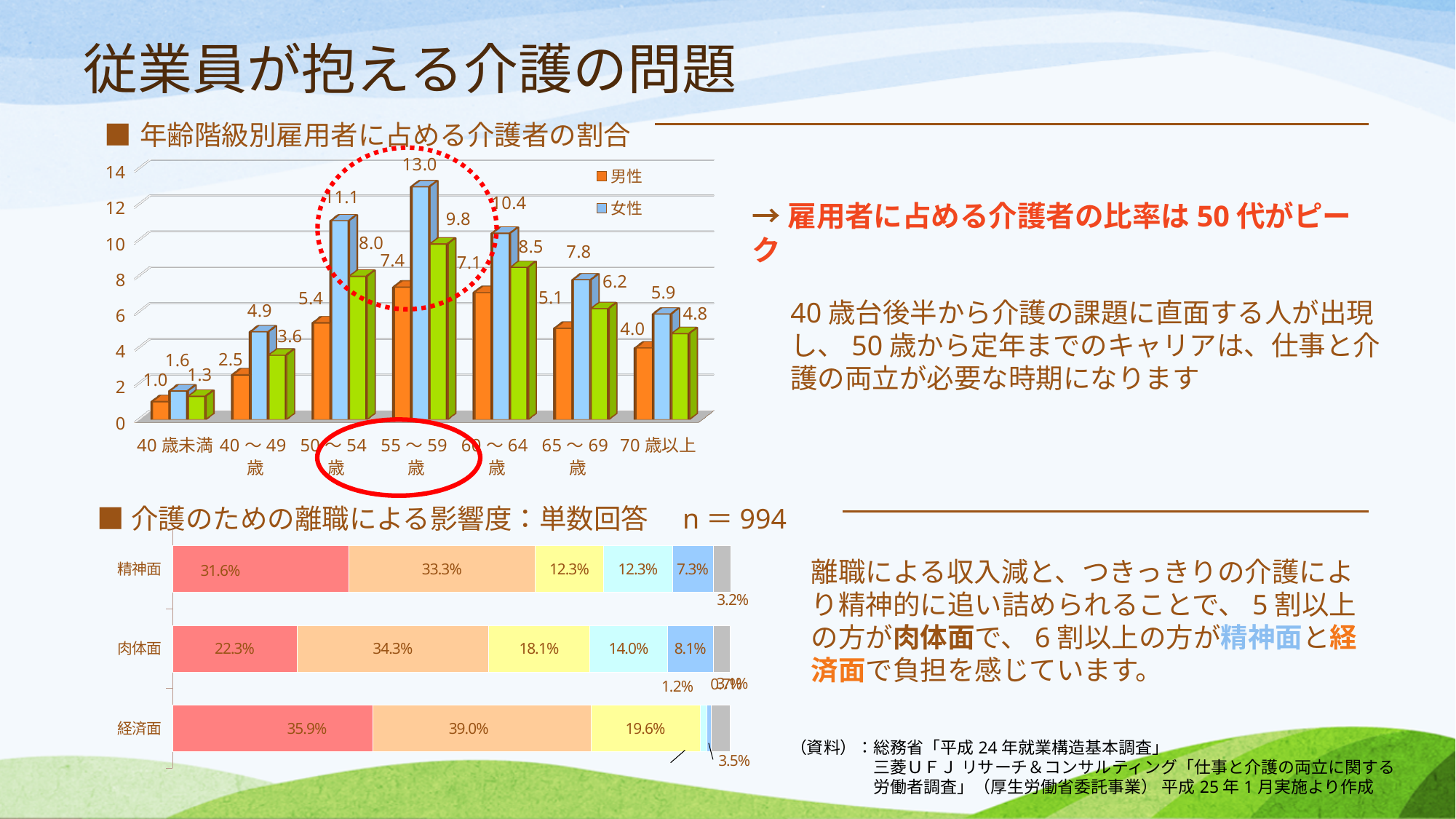
In the top chart (年齢階級別雇用者に占める介護者の割合), which is larger for 男性: 60～64歳 or 65～69歳? 60～64歳 In the bottom chart (介護のための離職による影響度), what is the value of the first (leftmost) segment of the 経済面 bar? 35.9% In the top chart (年齢階級別雇用者に占める介護者の割合), which age group has the highest 女性 value? 55～59歳 In the top chart (年齢階級別雇用者に占める介護者の割合), what is the difference between the 女性 and 男性 values for 55～59歳? 5.6 In the top chart (年齢階級別雇用者に占める介護者の割合), what is the 女性 value for 55～59歳? 13.0 How many categories are shown in the bottom chart (介護のための離職による影響度)? 3 In the bottom chart (介護のための離職による影響度), what is the value of the second segment of the 精神面 bar? 33.3% How many age groups are shown on the x axis of the top chart (年齢階級別雇用者に占める介護者の割合)? 7 What kind of chart is the top chart (年齢階級別雇用者に占める介護者の割合)? Bar chart In the top chart (年齢階級別雇用者に占める介護者の割合), which age group has the lowest 男性 value? 40歳未満 How many series does the legend of the top chart (年齢階級別雇用者に占める介護者の割合) list? 2 In the top chart (年齢階級別雇用者に占める介護者の割合), what is the 男性 value for 50～54歳? 5.4